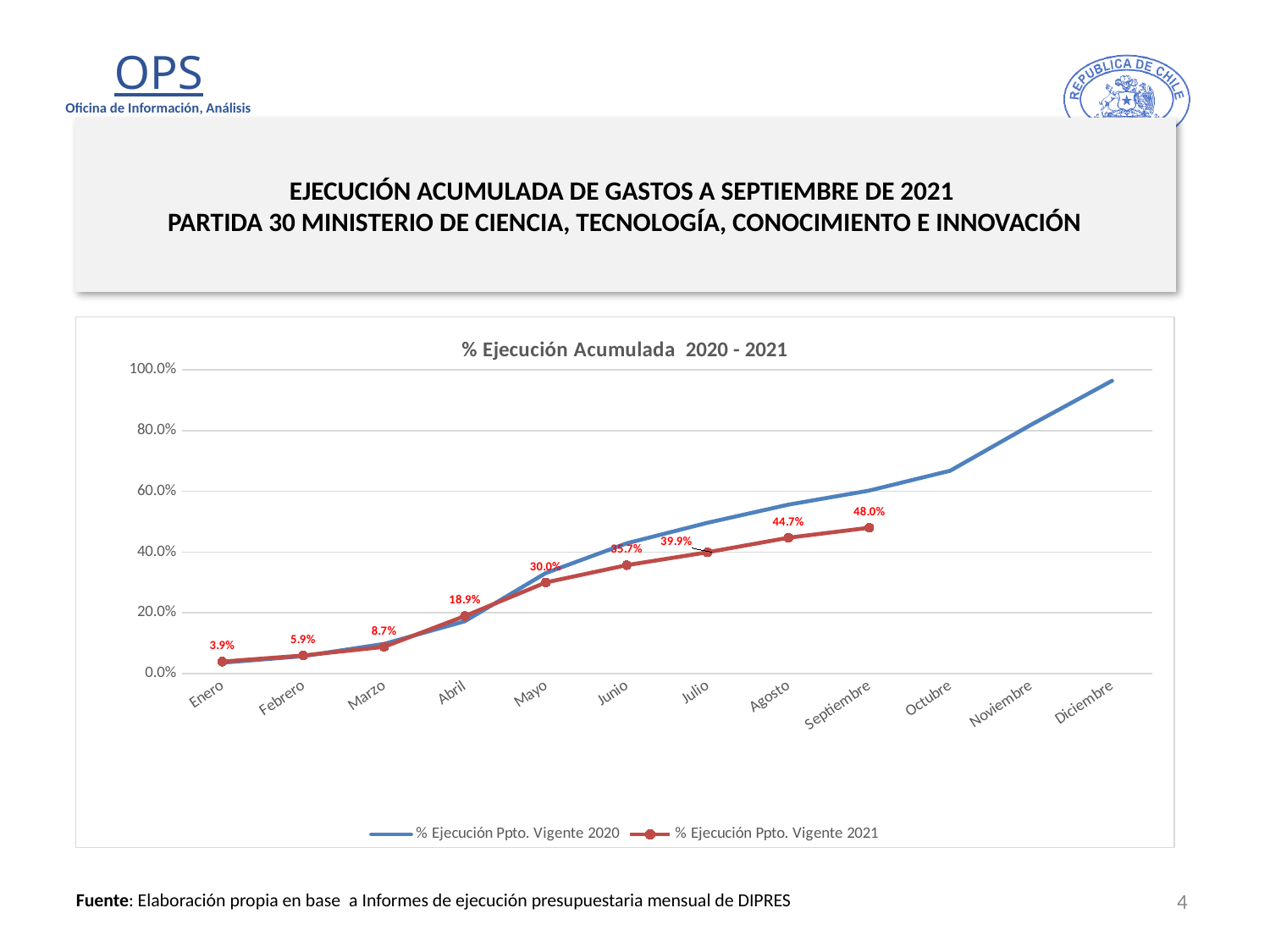
How many months are shown on the x axis of the chart? 12 Is the value of % Ejecución Ppto. Vigente 2020 for Diciembre greater or less than 80.0%? greater What is the value of % Ejecución Ppto. Vigente 2021 for Septiembre? 48.0% How many series does the chart legend list? 2 What kind of chart is shown on the slide? Line chart What is the value of % Ejecución Ppto. Vigente 2021 for Mayo? 30.0% What is the difference between the 2021 values for Mayo and Abril? 11.1% Which month has the highest labelled value for % Ejecución Ppto. Vigente 2021? Septiembre What is the difference between the 2021 values for Septiembre and Agosto? 3.3% Which month has the lowest labelled value for % Ejecución Ppto. Vigente 2021? Enero What is the value of % Ejecución Ppto. Vigente 2021 for Abril? 18.9% In Agosto, which series has the larger value, % Ejecución Ppto. Vigente 2020 or % Ejecución Ppto. Vigente 2021? % Ejecución Ppto. Vigente 2020